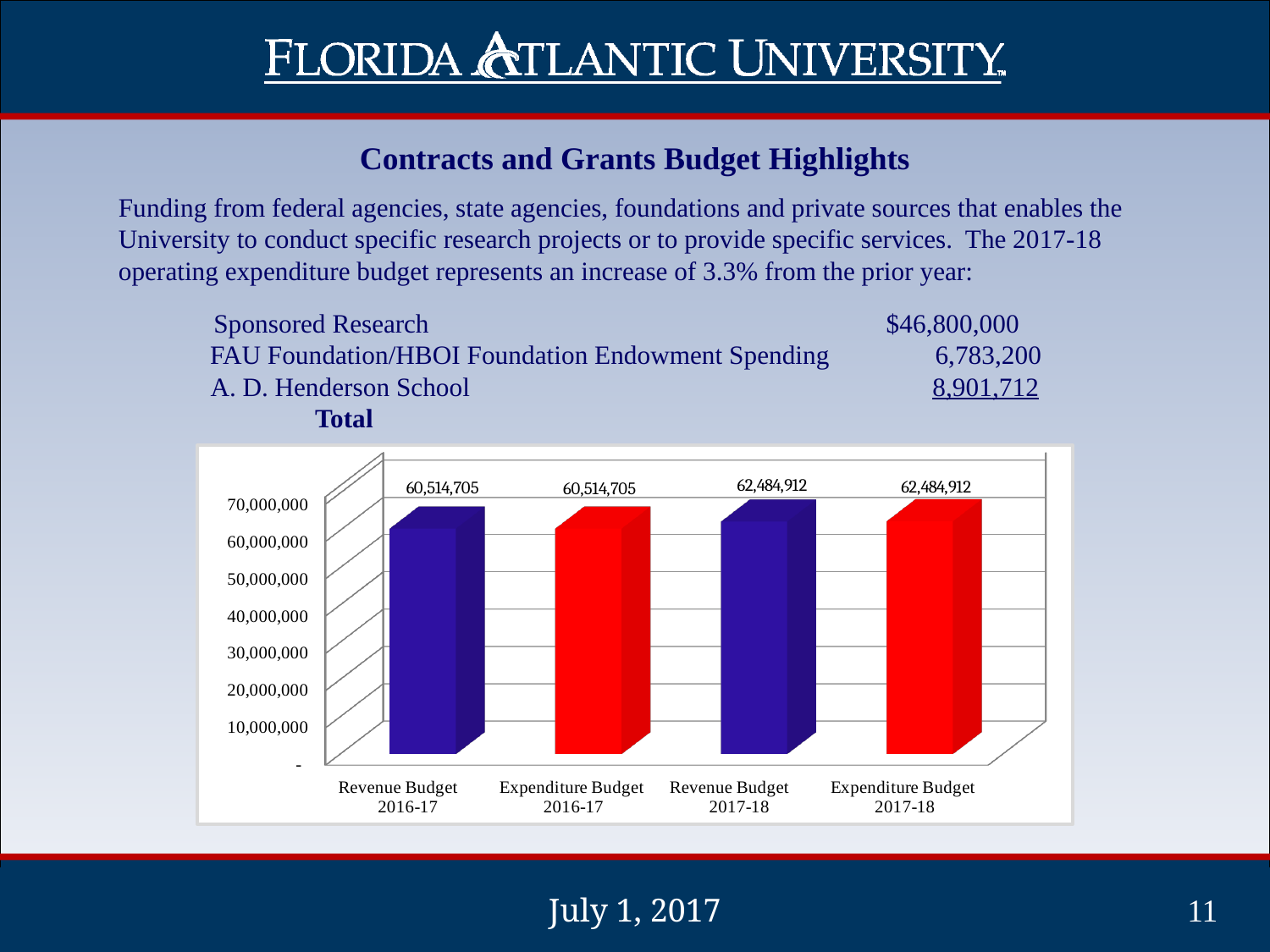
What is the value for Revenue Budget 2016-17? 60,514,705 What is the value for Expenditure Budget 2017-18? 62,484,912 What kind of chart is shown on the slide? bar chart Is the value for Expenditure Budget 2016-17 greater or less than 50,000,000? greater Which is larger, Expenditure Budget 2016-17 or Expenditure Budget 2017-18? Expenditure Budget 2017-18 Do the values rise or fall from the 2016-17 bars to the 2017-18 bars? rise Is the value for Revenue Budget 2017-18 greater or less than 70,000,000? less What is the value for Revenue Budget 2017-18? 62,484,912 What colour are the Revenue Budget bars? blue How many bars are shown in the chart? 4 What is the difference between Revenue Budget 2017-18 and Revenue Budget 2016-17? 1,970,207 What is the highest value shown on the vertical axis? 70,000,000